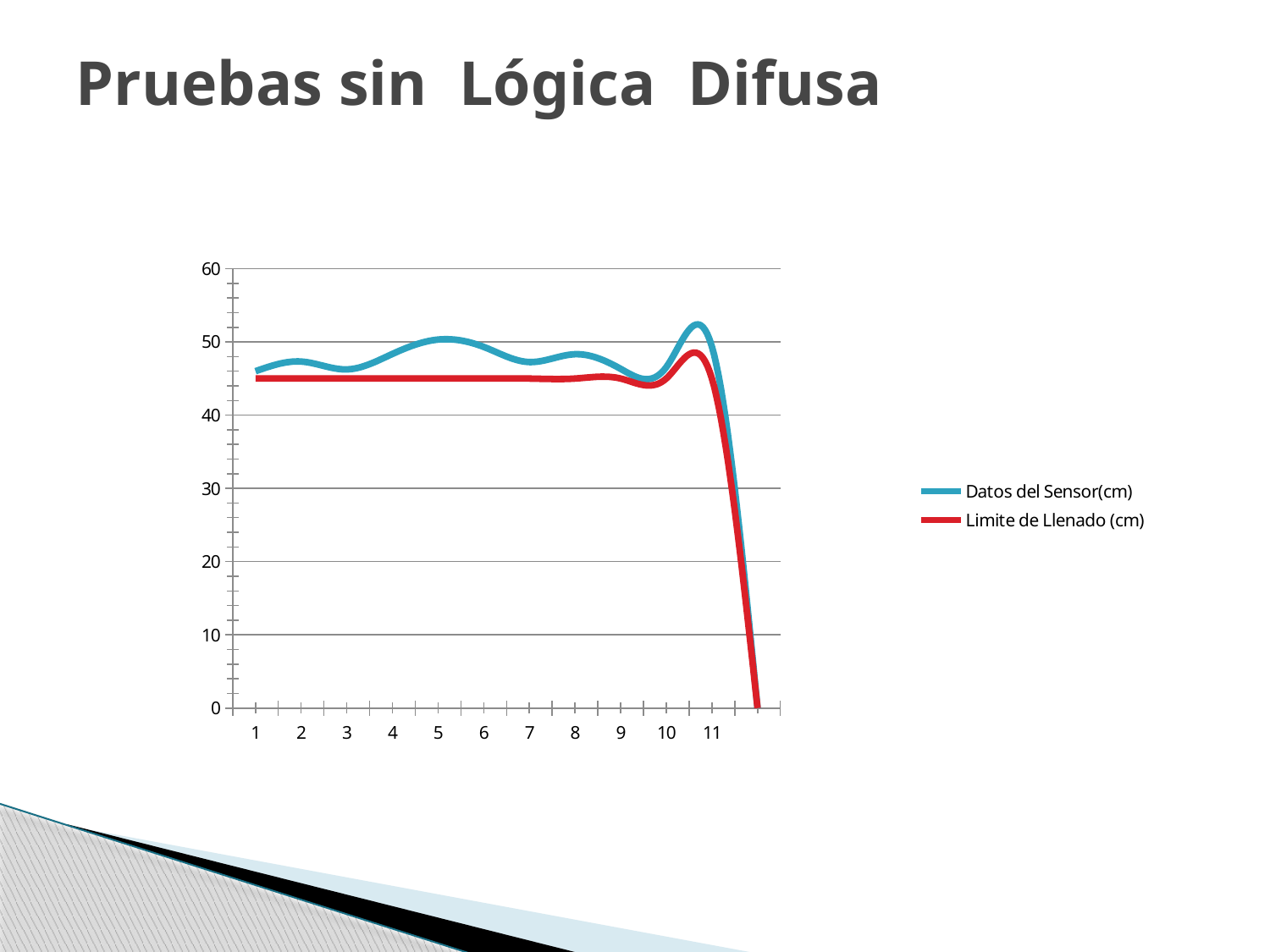
Which colour is used for the Limite de Llenado (cm) series? red Is the value of Datos del Sensor(cm) at x = 1 greater or less than 40? greater Is the value of Limite de Llenado (cm) at x = 11 greater or less than 50? less How many series does the legend list? 2 At x = 5, which series has the larger value, Datos del Sensor(cm) or Limite de Llenado (cm)? Datos del Sensor(cm) What kind of chart is shown on the slide? line chart At x = 8, which series has the larger value, Datos del Sensor(cm) or Limite de Llenado (cm)? Datos del Sensor(cm) Do both series rise or fall sharply after x = 11? fall Is the value of Limite de Llenado (cm) at x = 3 greater or less than 50? less Does the Datos del Sensor(cm) series rise or fall between x = 3 and x = 5? rise What are the two series named in the legend? Datos del Sensor(cm) and Limite de Llenado (cm)